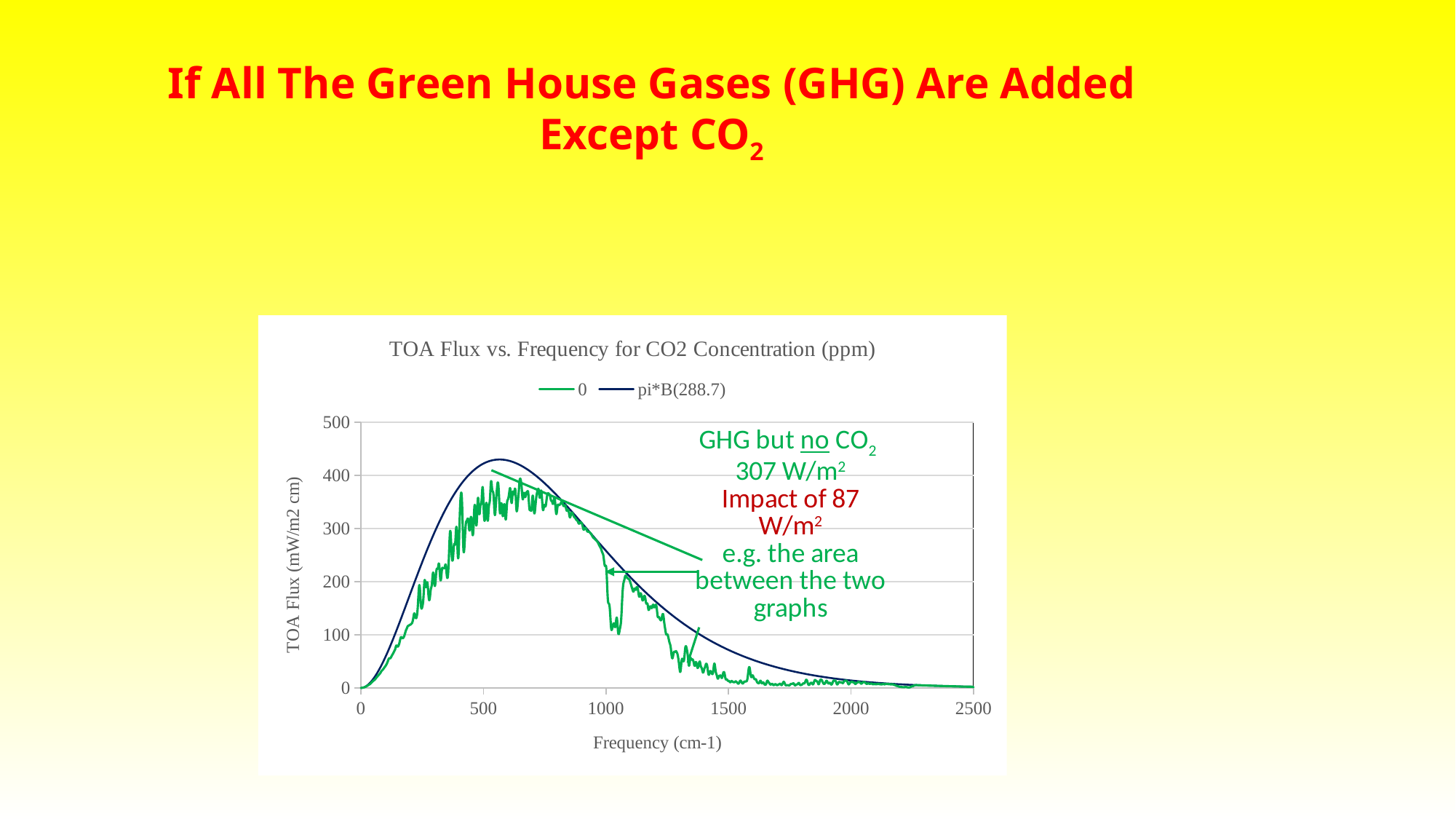
Is the value of the series labelled 0 at a frequency of 500 greater or less than 200? greater Is the value of the series labelled 0 at a frequency of 1500 greater or less than 100? less What is the title of the chart? TOA Flux vs. Frequency for CO2 Concentration (ppm) What is the label of the chart's x axis? Frequency (cm-1) Which series reaches the higher peak value, 0 or pi*B(288.7)? pi*B(288.7) Is the peak value of the pi*B(288.7) series greater or less than 400? greater Does the pi*B(288.7) series rise or fall as frequency increases from 1000 to 2500? fall How many series does the chart's legend list? 2 At a frequency of 1300, which series has the larger value, 0 or pi*B(288.7)? pi*B(288.7) What kind of chart is shown on the slide? line chart Does the pi*B(288.7) series rise or fall as frequency increases from 0 to 500? rise